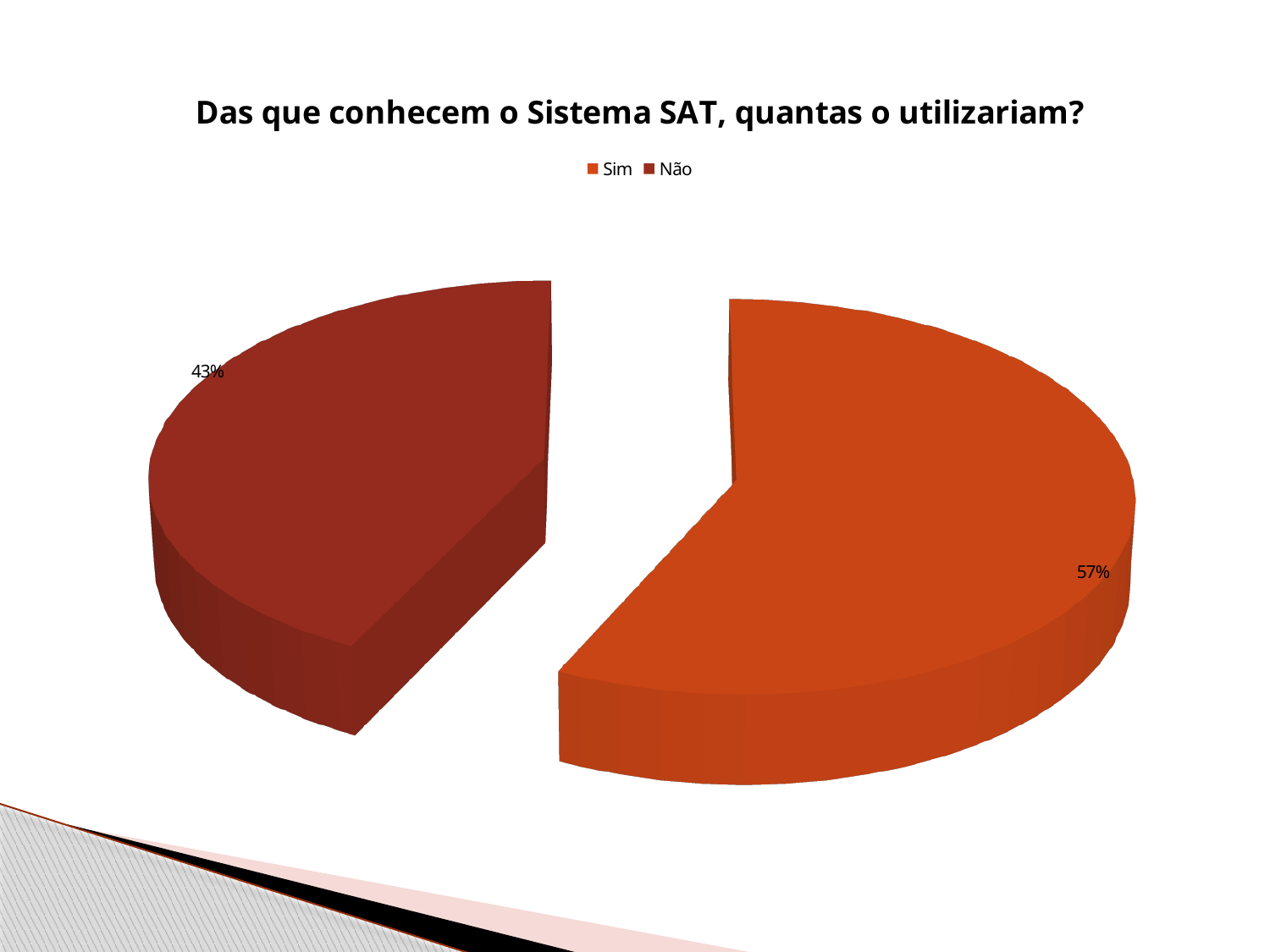
Which is larger, the "Sim" slice or the "Não" slice? Sim What is the title of the chart? Das que conhecem o Sistema SAT, quantas o utilizariam? What is the difference in percentage points between the "Sim" and "Não" slices? 14 How many entries does the legend list? 2 What share of the pie does the "Sim" slice represent? 57% How many slices does the pie chart have? 2 Which slice is the largest in the pie chart? Sim What share of the pie does the "Não" slice represent? 43% Which slice is the smallest in the pie chart? Não What kind of chart is shown on the slide? Pie chart Which legend entry is shown in the darker red colour? Não Is the "Sim" slice greater or less than 50% of the pie? greater